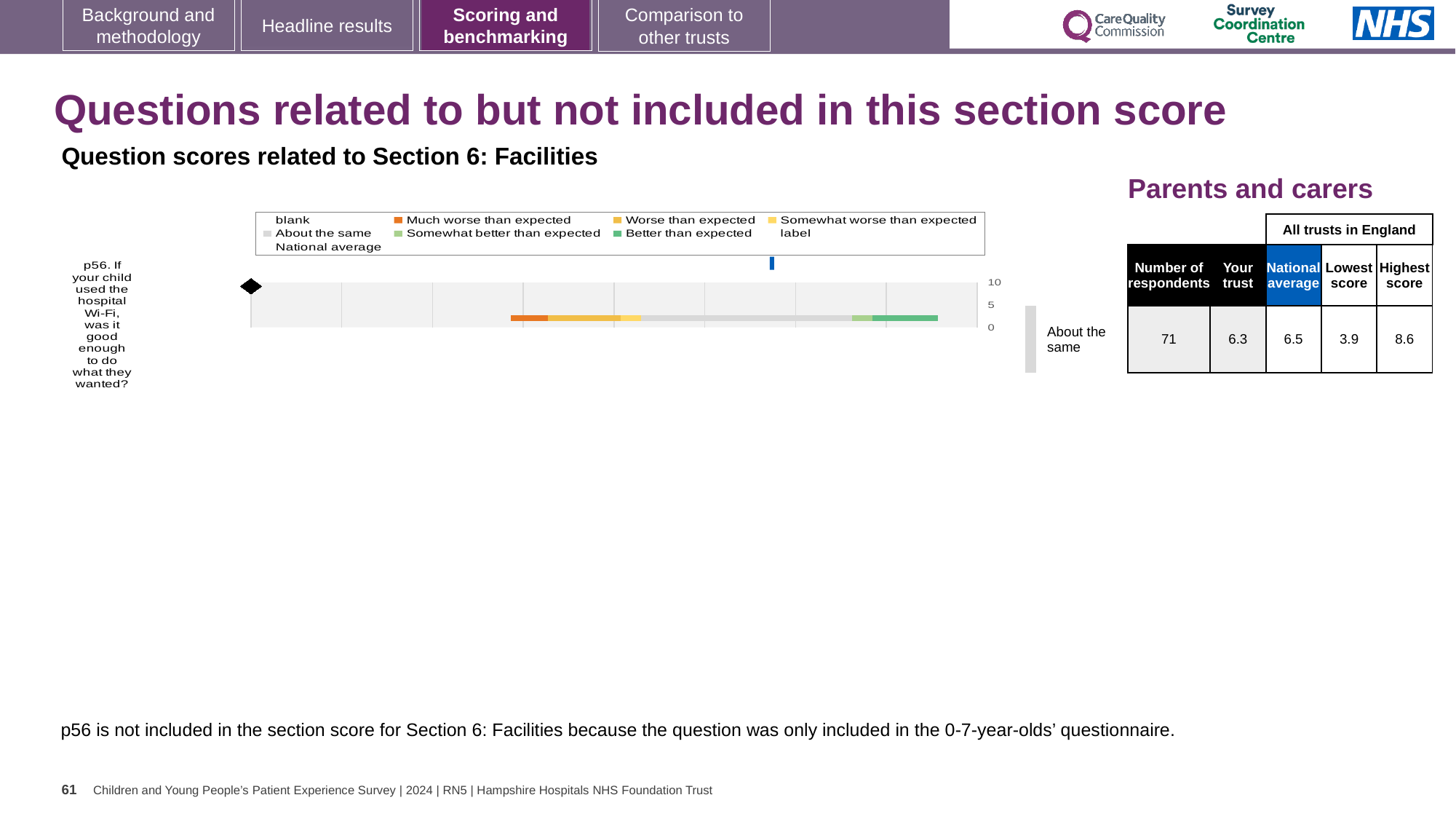
How many respondents answered p56? 71 What kind of chart is used to show the p56 question score? bar chart What is the national average score for p56? 6.5 Is the trust's score for p56 greater or less than 5? greater How is the trust's p56 result categorised relative to other trusts? About the same How many questions (categories) are plotted in the chart? 1 What is the highest score among all trusts in England for p56? 8.6 What is the difference between the highest and lowest trust scores for p56? 4.7 Which is larger for p56: the trust's score or the national average? National average What is the trust's score for p56 (If your child used the hospital Wi-Fi, was it good enough to do what they wanted?)? 6.3 What is the lowest score among all trusts in England for p56? 3.9 What is the highest value shown on the chart's axis? 10